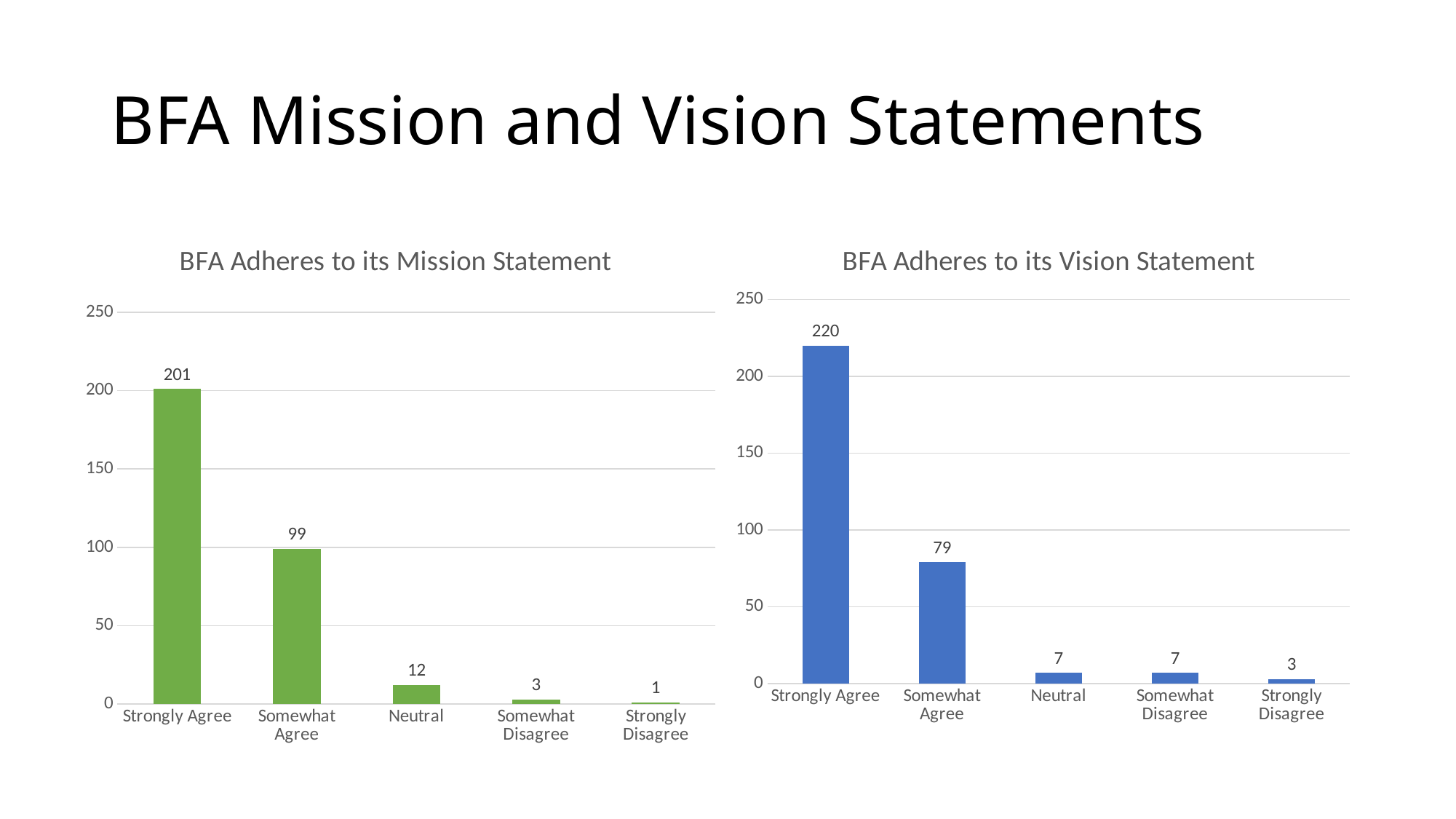
In the 'BFA Adheres to its Vision Statement' chart, what is the difference between Strongly Agree and Somewhat Agree? 141 In the 'BFA Adheres to its Vision Statement' chart, what is the value for Somewhat Agree? 79 In the 'BFA Adheres to its Vision Statement' chart, is the value for Somewhat Agree greater or less than 100? less Which is larger: Strongly Agree in the 'BFA Adheres to its Mission Statement' chart or Strongly Agree in the 'BFA Adheres to its Vision Statement' chart? Vision Statement (220) In the 'BFA Adheres to its Vision Statement' chart, which category has the highest value? Strongly Agree In the 'BFA Adheres to its Mission Statement' chart, what is the value for Strongly Agree? 201 What colour are the bars in the 'BFA Adheres to its Mission Statement' chart? Green What kind of chart is the 'BFA Adheres to its Vision Statement' chart? Bar chart How many categories are shown in the 'BFA Adheres to its Mission Statement' chart? 5 In the 'BFA Adheres to its Mission Statement' chart, do the values rise or fall from Strongly Agree to Strongly Disagree? Fall In the 'BFA Adheres to its Mission Statement' chart, which category has the lowest value? Strongly Disagree In the 'BFA Adheres to its Mission Statement' chart, what is the difference between Strongly Agree and Somewhat Agree? 102